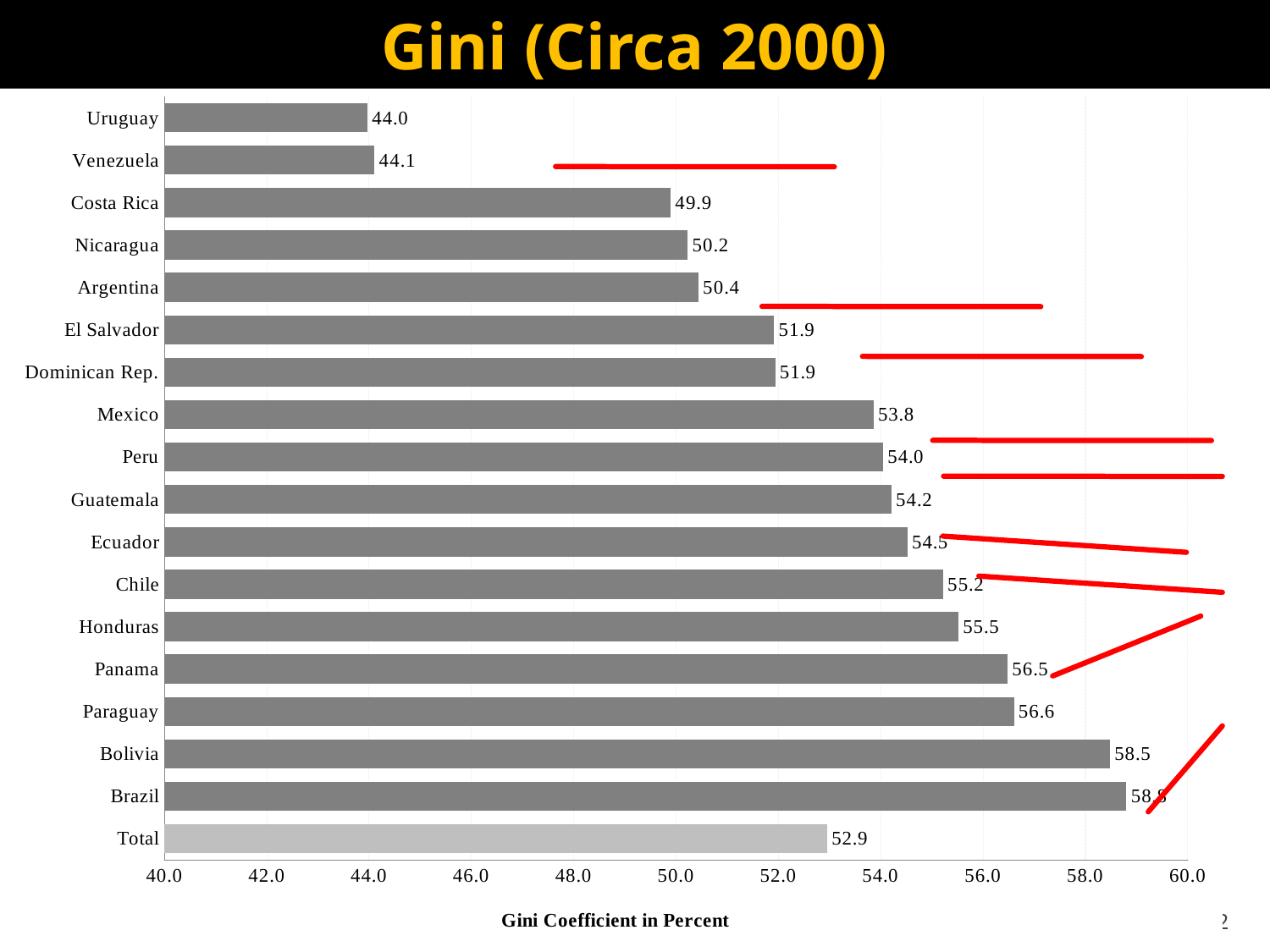
What is the difference between the values for Bolivia and Uruguay? 14.5 Which has a higher value, Panama or Honduras? Panama What is the label of the horizontal axis? Gini Coefficient in Percent How many bars are shown on the chart, including Total? 18 What value is shown for Costa Rica? 49.9 Is the value for Costa Rica greater or less than 50.0? less What value is shown for Bolivia? 58.5 What type of chart is shown on the slide? bar chart Which country has the highest Gini coefficient on the chart? Brazil What is the value of the Total bar? 52.9 What is the Gini coefficient shown for Uruguay? 44.0 Which country has the lowest Gini coefficient on the chart? Uruguay